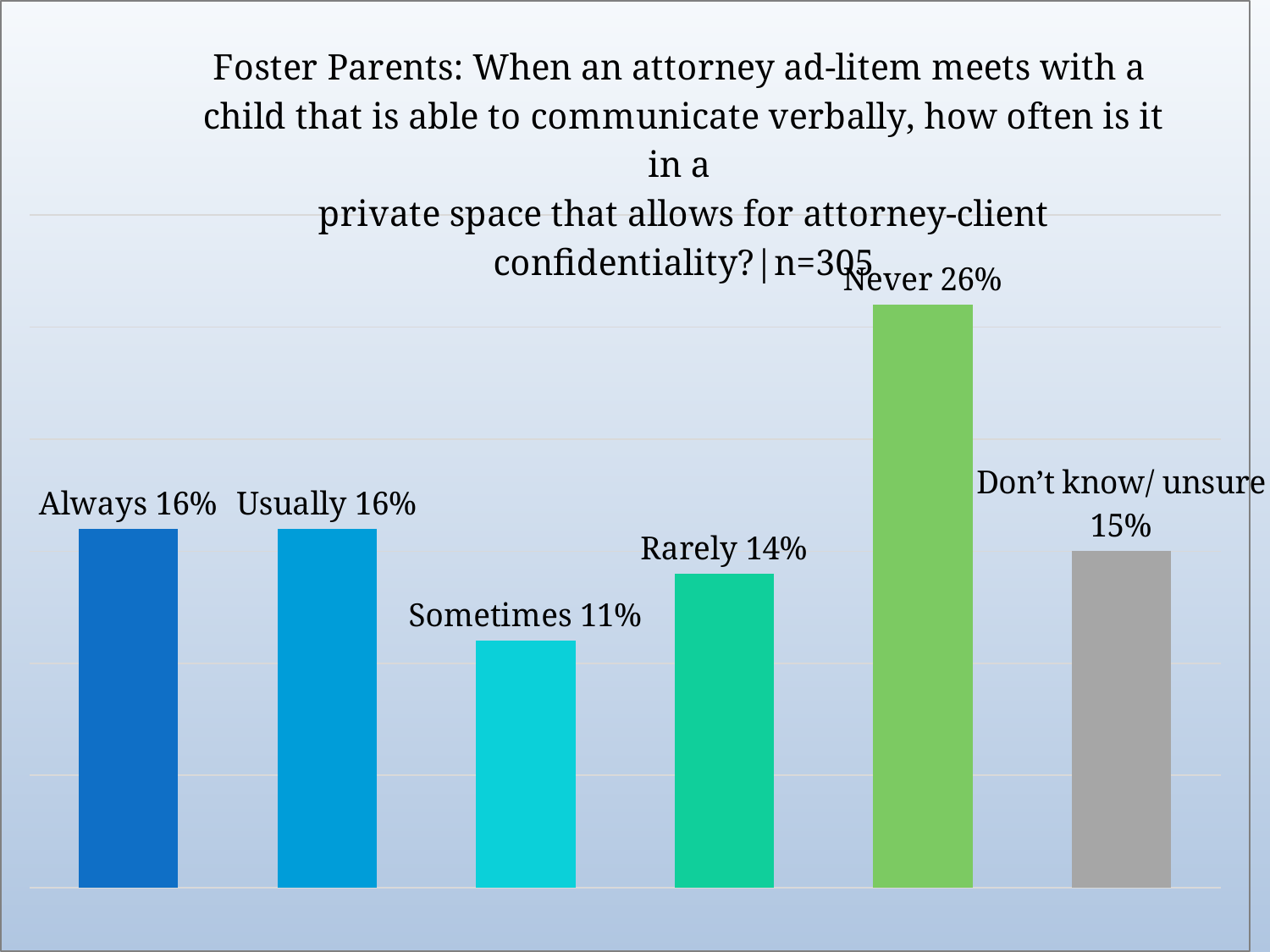
How many response categories are shown in the chart? 6 What is the sample size (n) stated in the chart title? 305 Which is larger, the value for "Rarely" or the value for "Don't know/ unsure"? Don't know/ unsure What percentage of foster parents answered "Don't know/ unsure"? 15% What is the difference in percentage points between "Rarely" and "Sometimes"? 3 What percentage of foster parents answered "Never"? 26% What is the difference in percentage points between "Never" and "Always"? 10 What percentage of foster parents answered "Rarely"? 14% Which response category has the highest percentage? Never What kind of chart is shown on the slide? Bar chart Which response category has the lowest percentage? Sometimes What percentage of foster parents answered "Sometimes"? 11%